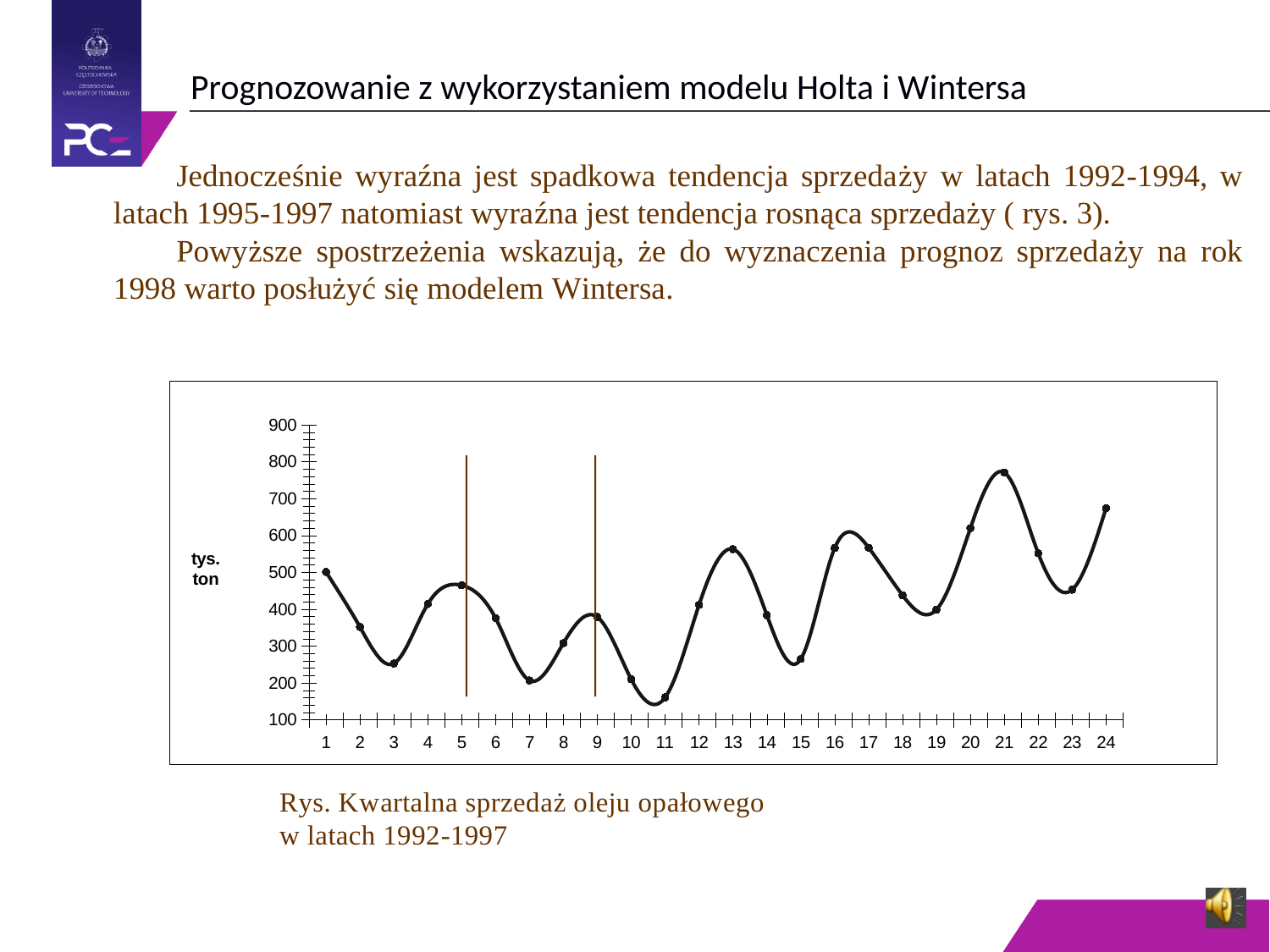
Which has the larger value, point 21 or point 13? 21 Is the value at point 11 greater or less than 200? less Is the value at point 7 greater or less than 300? less What kind of chart is shown on the slide? line chart Is the value at point 13 greater or less than 500? greater Which has the larger value, point 3 or point 11? 3 How many data points are plotted along the x axis of the chart? 24 At which x-axis point does the line reach its highest value? 21 What is the label on the y axis of the chart? tys. ton Do the values rise or fall from point 11 to point 13? rise At which x-axis point does the line reach its lowest value? 11